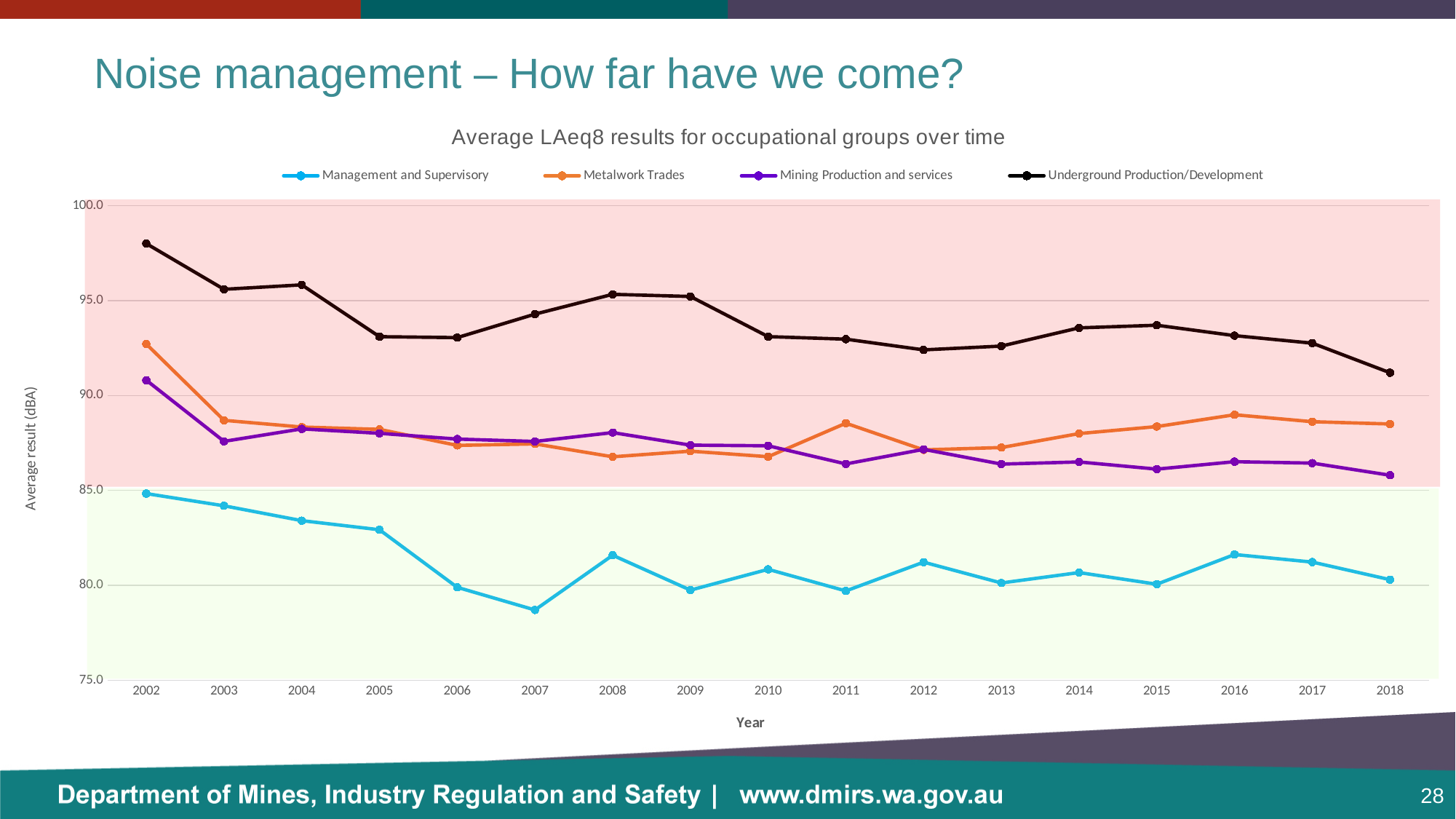
Which occupational group has the highest value in 2002? Underground Production/Development In which year is the Management and Supervisory value lowest? 2007 How many years are plotted along the x axis? 17 How many series does the legend list? 4 Is the value for Management and Supervisory in 2006 greater or less than 85? less Which is larger in 2011, the value for Metalwork Trades or the value for Mining Production and services? Metalwork Trades What kind of chart is shown on the slide? Line chart What is the title of the chart? Average LAeq8 results for occupational groups over time Is the value for Underground Production/Development in 2002 greater or less than 95? greater Does the Underground Production/Development line rise or fall overall from 2002 to 2018? Fall What is the label of the vertical axis? Average result (dBA) In which year is the Underground Production/Development value highest? 2002